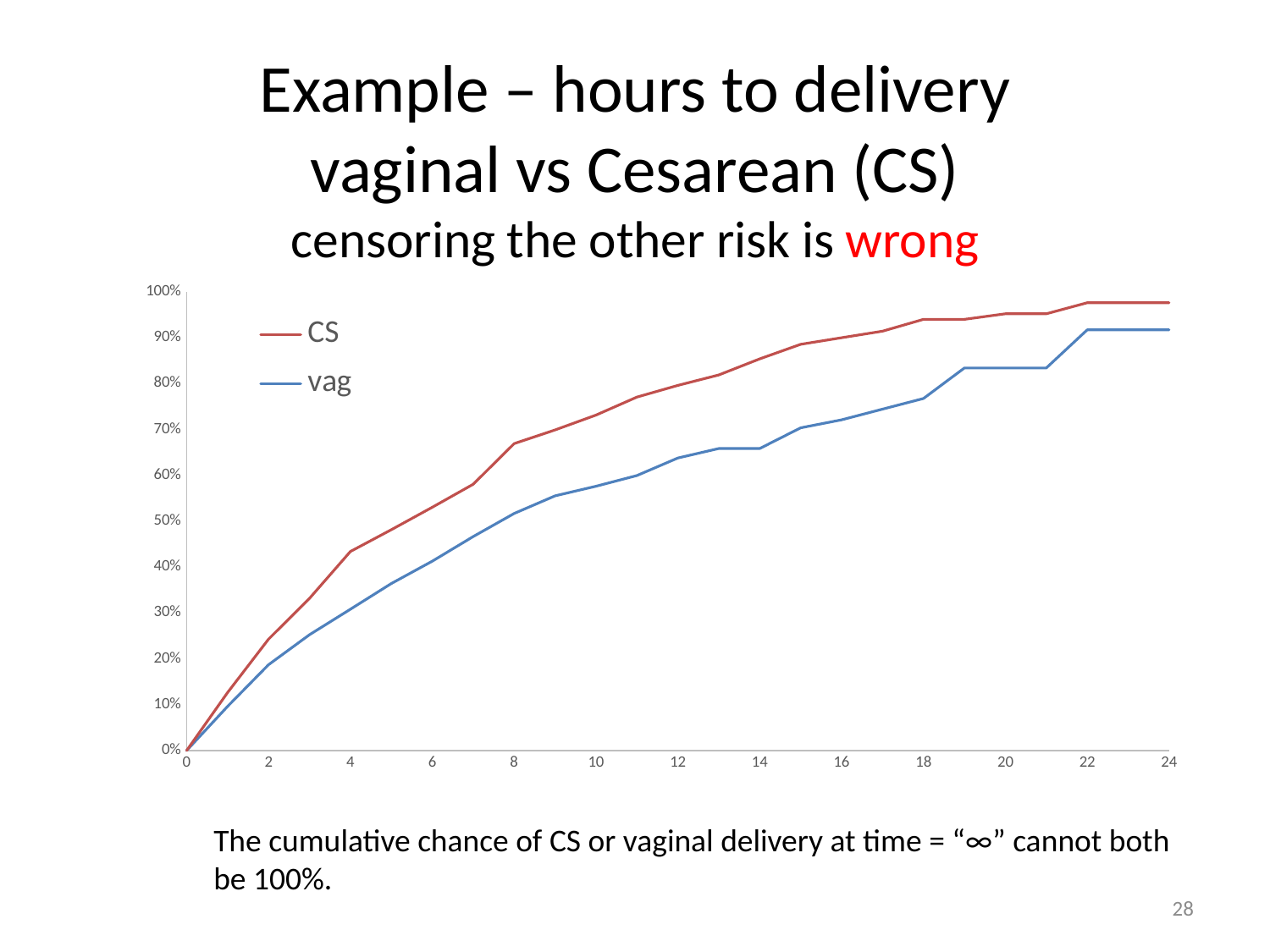
At x = 8, which series has the higher value, CS or vag? CS Is the value for vag at x = 19 greater or less than 80%? greater Is the value for CS at x = 24 greater or less than 90%? greater What is the value of the vag series at x = 0? 0% Is the value for CS at x = 4 greater or less than 40%? greater Do the values of the CS series rise or fall as the x axis increases from 0 to 24? rise How many series does the legend list? 2 What kind of chart is shown on the slide? line chart What colour is the CS line? red What are the two series named in the legend? CS and vag